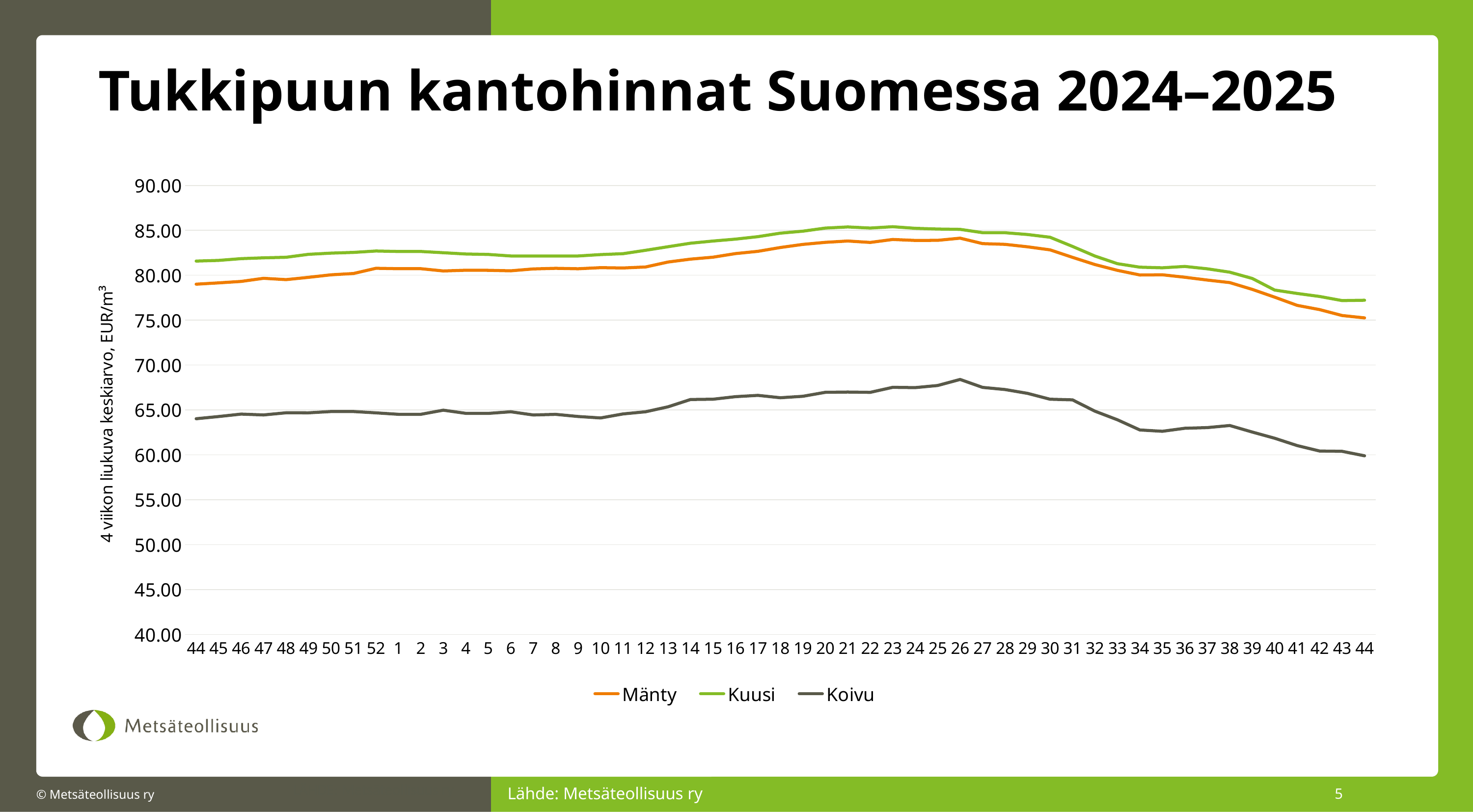
What is the title of the chart? Tukkipuun kantohinnat Suomessa 2024–2025 How many series does the legend list? 3 Which series has the highest values across the whole chart? Kuusi Do the Mänty values rise or fall from the first week 44 to week 26? rise At week 20, which is larger, the value for Kuusi or the value for Mänty? Kuusi Is the value for Koivu at the last week 44 greater or less than 65.00? less Is the value for Koivu at week 26 greater or less than 65.00? greater Do the Koivu values rise or fall from week 26 to the final week 44? fall Which series is plotted with the orange line? Mänty Which series has the lowest values across the whole chart? Koivu What kind of chart is shown on the slide? Line chart Is the value for Mänty at the last week 44 greater or less than 80.00? less